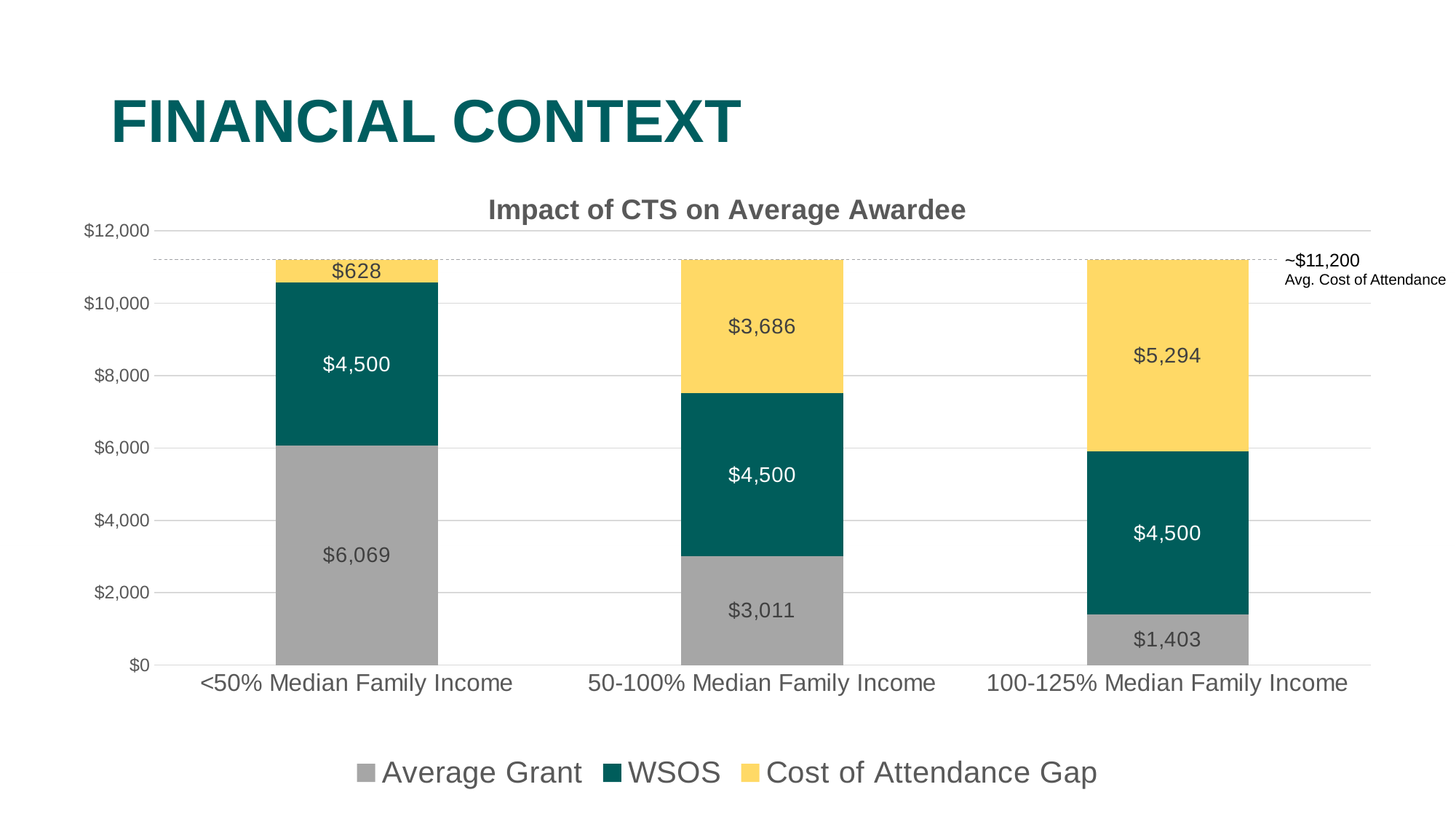
Which category has the highest Cost of Attendance Gap? 100-125% Median Family Income What is the Average Grant value for the <50% Median Family Income category? $6,069 Which category has the lowest Average Grant? 100-125% Median Family Income What is the difference between the Average Grant for <50% Median Family Income and for 50-100% Median Family Income? $3,058 What is the total of the stacked bar for the 50-100% Median Family Income category? $11,197 How many series does the legend list? 3 What kind of chart is shown on the slide? Stacked bar chart What is the WSOS value for the 50-100% Median Family Income category? $4,500 What is the Cost of Attendance Gap for the 100-125% Median Family Income category? $5,294 How many categories are shown on the x axis? 3 What is the title of the chart? Impact of CTS on Average Awardee Is the Cost of Attendance Gap larger for 50-100% Median Family Income or for 100-125% Median Family Income? 100-125% Median Family Income